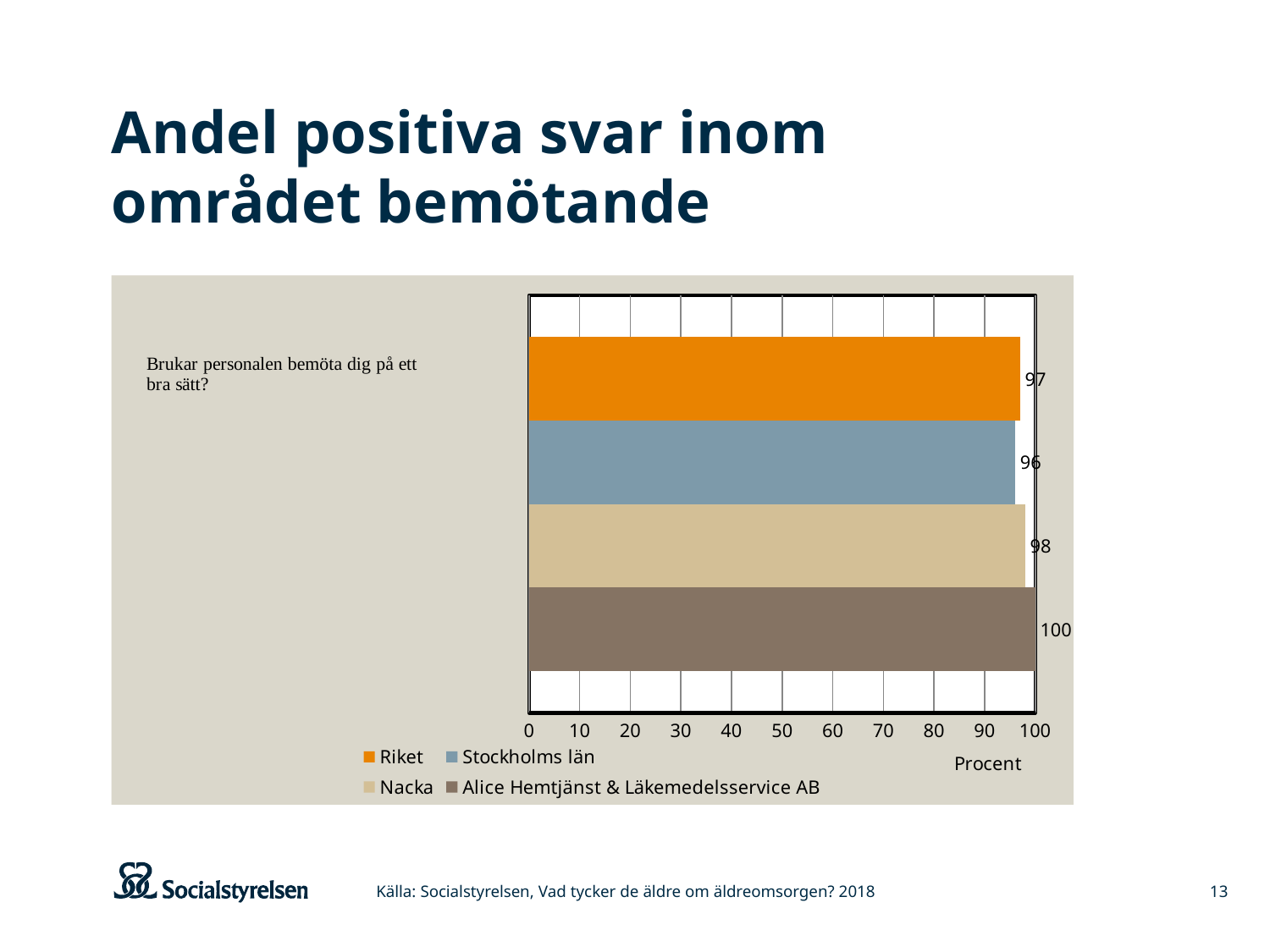
Which series has the lowest value? Stockholms län What is the label on the horizontal axis of the chart? Procent Which is larger, the value for Nacka or the value for Riket? Nacka What is the difference between the values for Alice Hemtjänst & Läkemedelsservice AB and Stockholms län? 4 What is the value for Stockholms län? 96 What is the difference between the values for Nacka and Riket? 1 Which series has the highest value? Alice Hemtjänst & Läkemedelsservice AB What is the value for Riket? 97 What is the value for Nacka? 98 What is the value for Alice Hemtjänst & Läkemedelsservice AB? 100 How many series does the legend list? 4 What kind of chart is shown on the slide? Bar chart